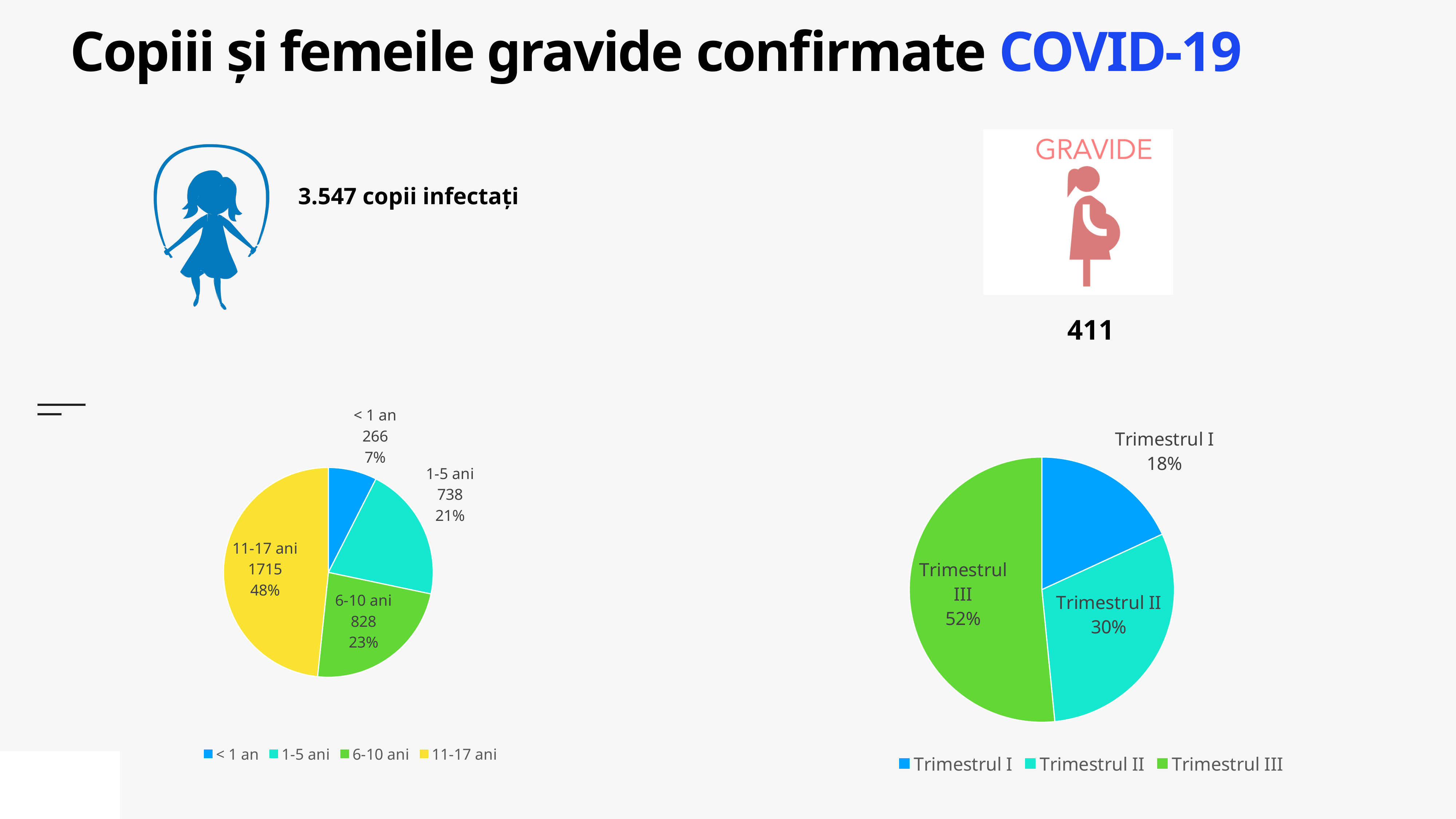
In the right pie chart (pregnant women by trimester), which trimester has the largest share? Trimestrul III In the left pie chart (children by age group), which is larger: 1-5 ani or 6-10 ani? 6-10 ani In the left pie chart (children by age group), how many age groups are shown? 4 In the left pie chart (children by age group), what is the difference between the 1-5 ani and < 1 an values? 472 In the left pie chart (children by age group), what percentage share does the 11-17 ani slice have? 48% In the left pie chart (children by age group), which age group has the highest value? 11-17 ani In the left pie chart (children by age group), which age group has the lowest value? < 1 an In the right pie chart (pregnant women by trimester), what percentage share does Trimestrul II have? 30% In the right pie chart (pregnant women by trimester), which trimester has the smallest share? Trimestrul I In the right pie chart (pregnant women by trimester), how many entries does the legend list? 3 In the left pie chart (children by age group), what is the value for the 6-10 ani slice? 828 What kind of chart is the right chart (pregnant women by trimester)? Pie chart